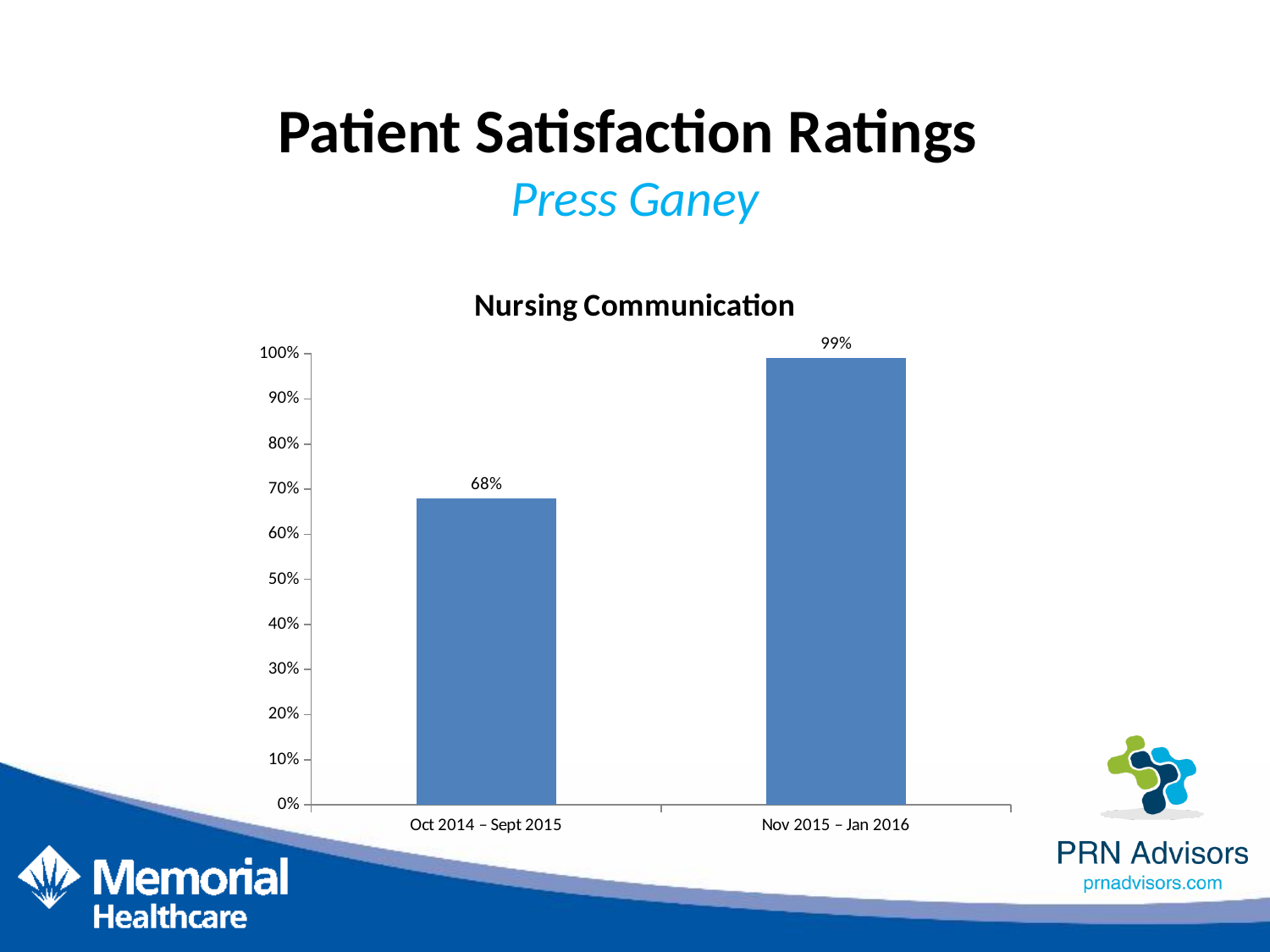
Does the Nursing Communication rating rise or fall from the earlier period to the later period? Rise What type of chart is used to show the Nursing Communication ratings? Bar chart Is the Nursing Communication rating for Nov 2015 – Jan 2016 greater or less than 90%? greater Which period has the higher Nursing Communication rating? Nov 2015 – Jan 2016 How many periods are shown on the Nursing Communication chart? 2 By how many percentage points did the Nursing Communication rating increase from Oct 2014 – Sept 2015 to Nov 2015 – Jan 2016? 31 percentage points What is the Nursing Communication value for Oct 2014 – Sept 2015? 68% What is the maximum value shown on the vertical axis of the chart? 100% Which period has the lower Nursing Communication rating? Oct 2014 – Sept 2015 Is the Nursing Communication rating for Oct 2014 – Sept 2015 greater or less than 70%? less What is the title of the chart on the slide? Nursing Communication What is the Nursing Communication value for Nov 2015 – Jan 2016? 99%